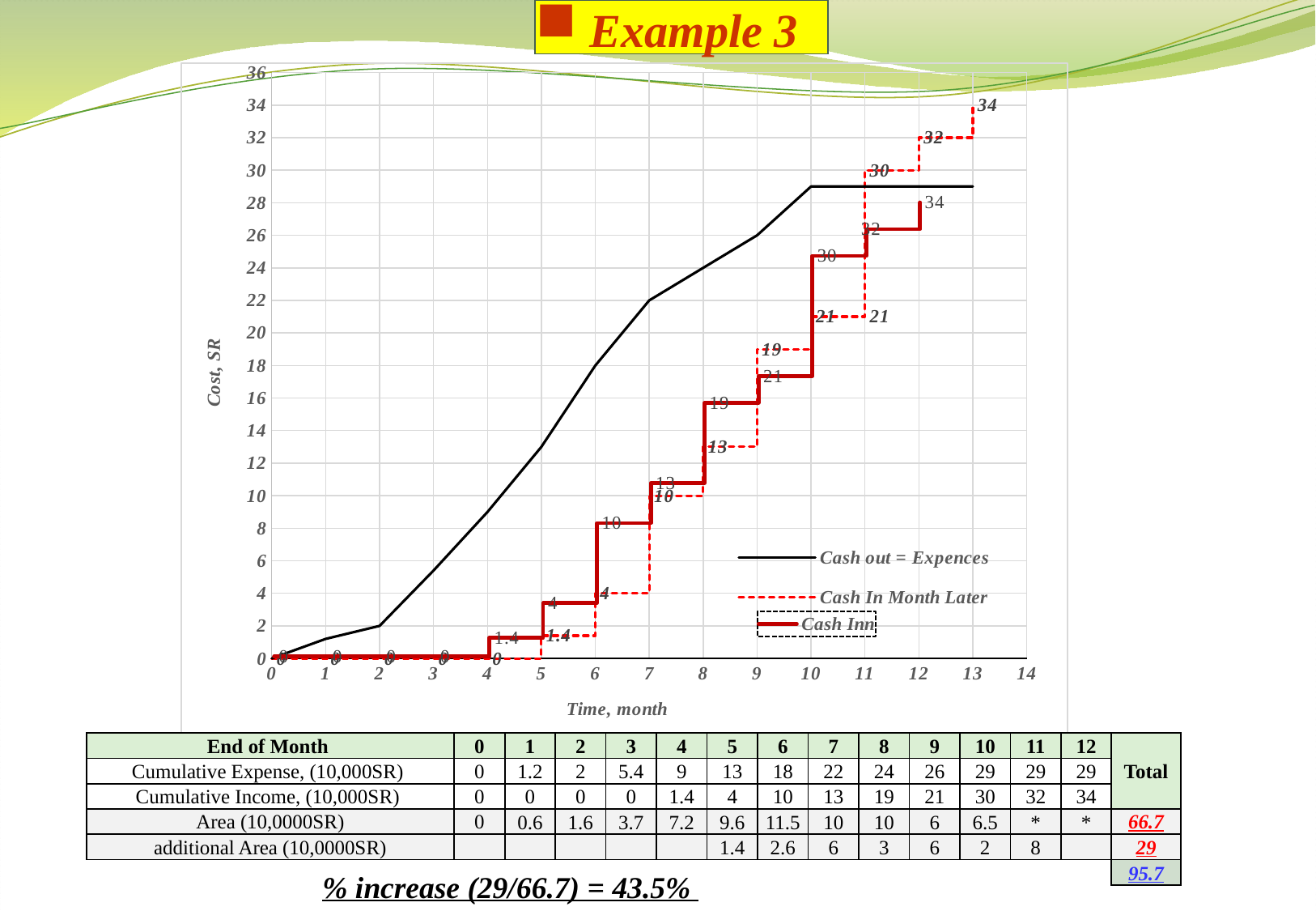
What is the value of the Cash Inn series at month 8? 19 Is the value of the Cash out = Expences series at month 5 greater or less than 12? greater Does the Cash Inn series rise or fall as time increases along the x axis? rise At month 8, which is larger: Cash out = Expences or Cash Inn? Cash out = Expences What is the difference between the Cash Inn values at month 12 and month 11? 2 What is the title of the x axis of the chart? Time, month What is the value of the Cash In Month Later series at month 11? 30 Which series has the highest value at month 12? Cash Inn How many series does the chart legend list? 3 What is the value of the Cash Inn series at month 12? 34 What is the value of the Cash In Month Later series at month 13? 34 What kind of chart is shown on the slide? line chart